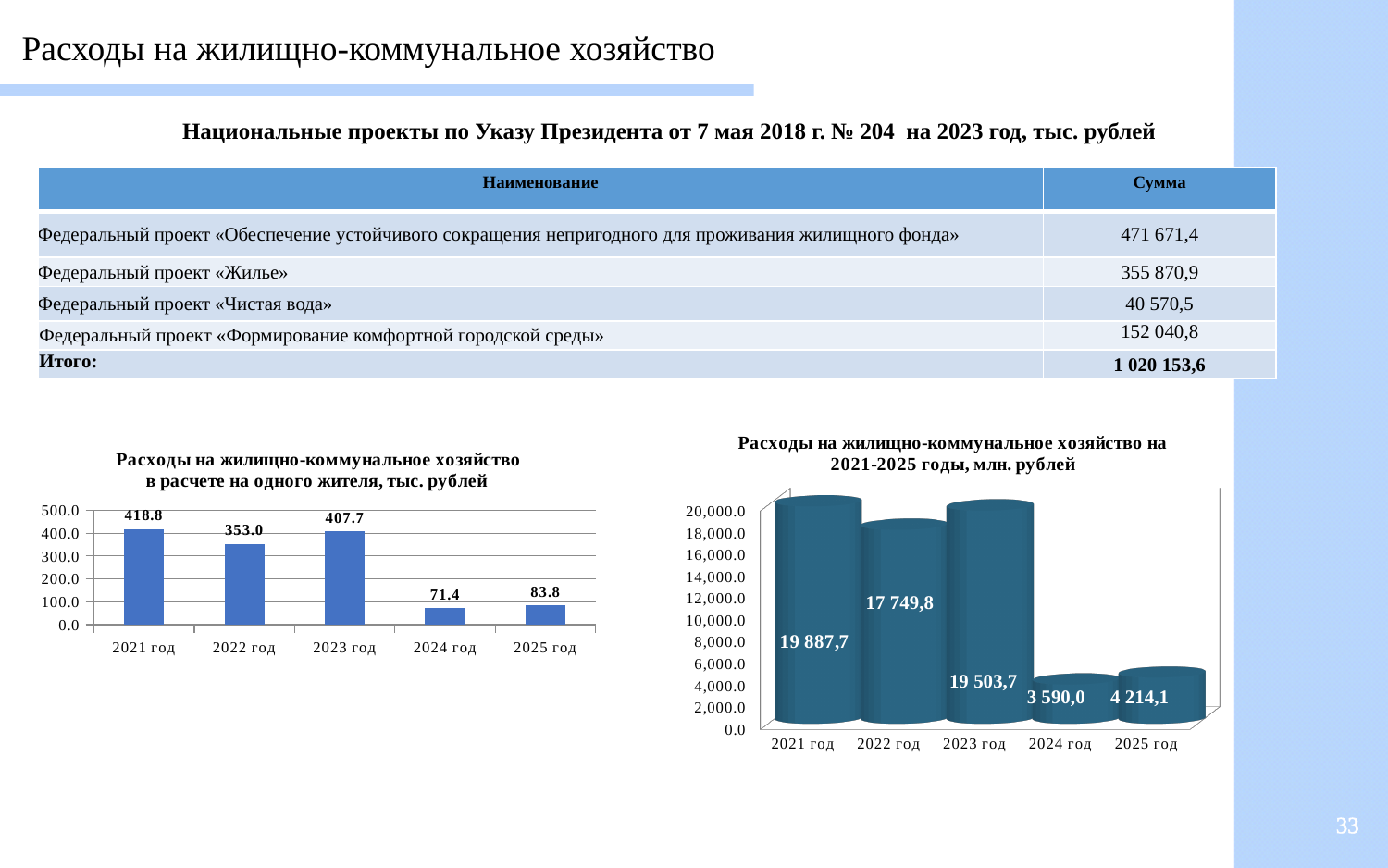
In the left chart (per-resident expenses, thousand rubles), which year has the lowest value? 2024 год In the right chart (expenses for 2021-2025, million rubles), what is the value for 2025 год? 4 214,1 In the right chart (expenses for 2021-2025, million rubles), which year has the lowest value? 2024 год In the right chart (expenses for 2021-2025, million rubles), which is larger: the value for 2021 год or 2023 год? 2021 год In the right chart (expenses for 2021-2025, million rubles), what is the value for 2022 год? 17 749,8 In the left chart (per-resident expenses, thousand rubles), what is the value for 2021 год? 418.8 In the left chart (per-resident expenses, thousand rubles), what is the value for 2024 год? 71.4 In the left chart (per-resident expenses, thousand rubles), what is the difference between the values for 2021 год and 2022 год? 65.8 In the left chart (per-resident expenses, thousand rubles), how many years are shown on the x axis? 5 What kind of chart is the left chart (per-resident expenses, thousand rubles)? bar chart In the right chart (expenses for 2021-2025, million rubles), is the value for 2024 год greater or less than 4,000.0? less In the left chart (per-resident expenses, thousand rubles), which year has the highest value? 2021 год